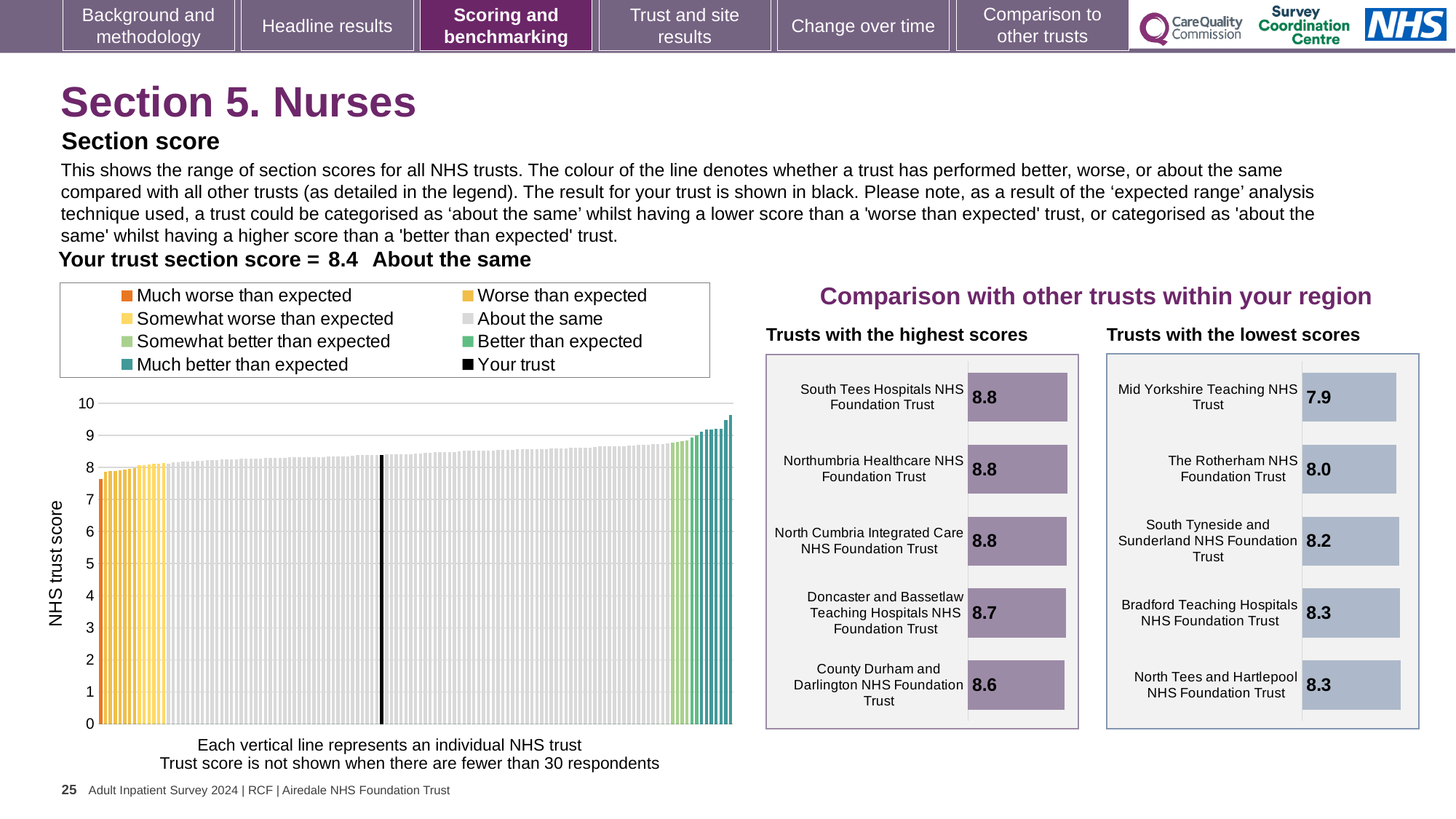
In the 'Trusts with the lowest scores' chart, which has the higher score: The Rotherham NHS Foundation Trust or South Tyneside and Sunderland NHS Foundation Trust? South Tyneside and Sunderland NHS Foundation Trust In the 'Trusts with the lowest scores' chart, which trust has the lowest score? Mid Yorkshire Teaching NHS Trust In the large chart on the left, is the value for the black 'Your trust' bar greater or less than 8? greater In the 'Trusts with the lowest scores' chart, what is the score for The Rotherham NHS Foundation Trust? 8.0 In the 'Trusts with the highest scores' chart, what is the score for Doncaster and Bassetlaw Teaching Hospitals NHS Foundation Trust? 8.7 In the large chart on the left, do the trust scores rise or fall from left to right along the x axis? rise In the 'Trusts with the highest scores' chart, which trust has the lowest score? County Durham and Darlington NHS Foundation Trust How many entries does the legend of the large chart on the left list? 8 In the 'Trusts with the lowest scores' chart, what is the difference between the scores of Bradford Teaching Hospitals NHS Foundation Trust and Mid Yorkshire Teaching NHS Trust? 0.4 In the 'Trusts with the highest scores' chart, what is the difference between the scores of South Tees Hospitals NHS Foundation Trust and County Durham and Darlington NHS Foundation Trust? 0.2 How many trusts are shown in the 'Trusts with the highest scores' chart? 5 What type of chart is the large chart on the left showing NHS trust scores? bar chart